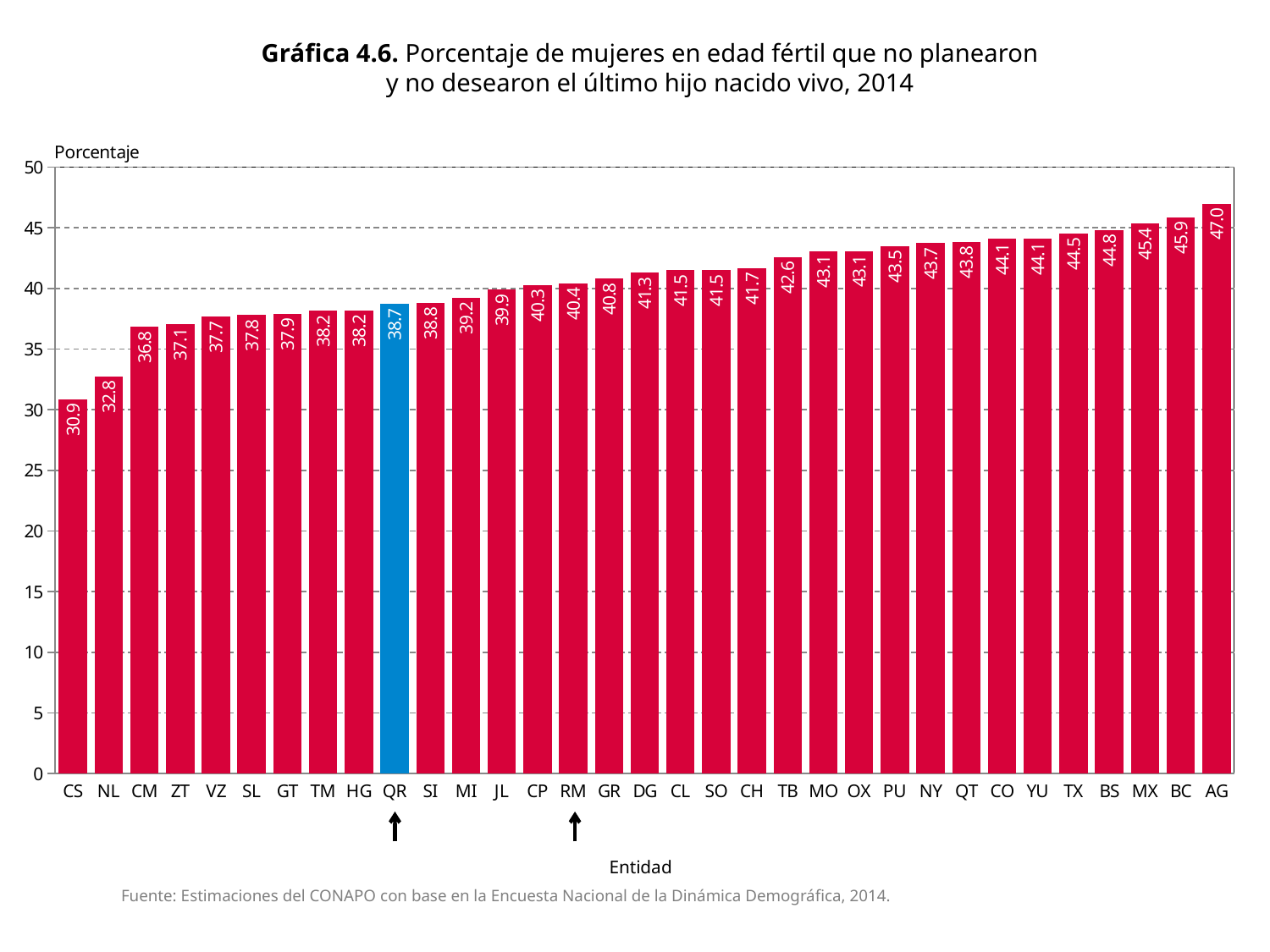
What kind of chart is this? Bar chart Which entity's bar is coloured blue instead of red? QR What is the value for RM? 40.4 What is the value for CS? 30.9 Is the value for BC greater or less than 45? greater How many entities are shown on the x axis? 33 What is the value for QR? 38.7 Do the values rise or fall from left to right along the x axis? Rise What is the difference between the values for AG and CS? 16.1 Which entity has the lowest value? CS Which entity has the highest value? AG Which is larger, the value for NL or the value for CM? CM